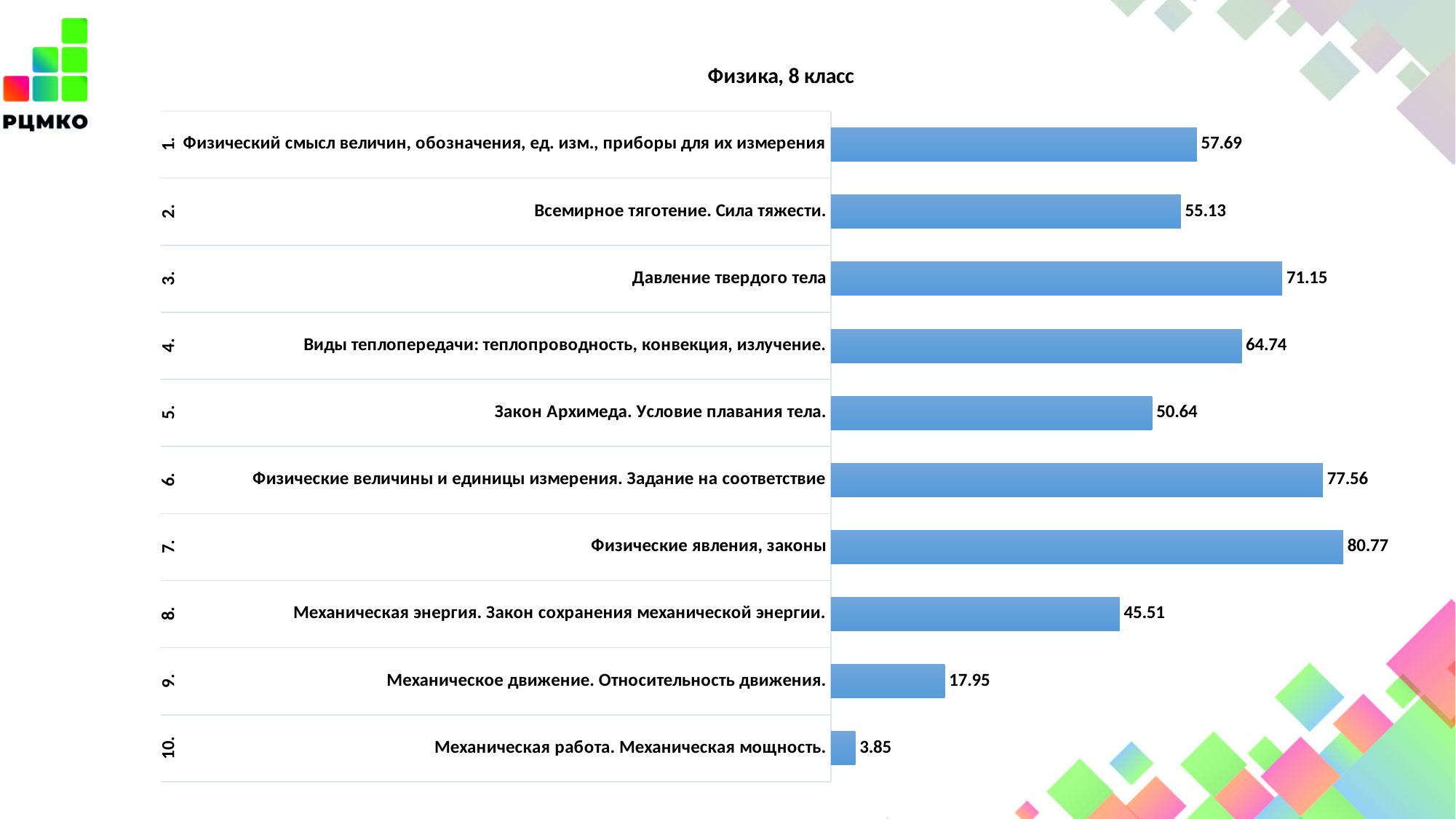
What is the value for "Давление твердого тела"? 71.15 What is the value for "Механическое движение. Относительность движения."? 17.95 Which is larger: the value for "Физический смысл величин, обозначения, ед. изм., приборы для их измерения" or the value for "Всемирное тяготение. Сила тяжести."? Физический смысл величин, обозначения, ед. изм., приборы для их измерения Which category has the highest value? Физические явления, законы What is the value for "Закон Архимеда. Условие плавания тела."? 50.64 How many categories are shown in the chart? 10 What kind of chart is shown on the slide? Bar chart Which category has the lowest value? Механическая работа. Механическая мощность. What is the value for "Механическая энергия. Закон сохранения механической энергии."? 45.51 What is the difference between the values for "Физические явления, законы" and "Физические величины и единицы измерения. Задание на соответствие"? 3.21 What is the difference between the values for "Виды теплопередачи: теплопроводность, конвекция, излучение." and "Всемирное тяготение. Сила тяжести."? 9.61 What is the title of the chart? Физика, 8 класс